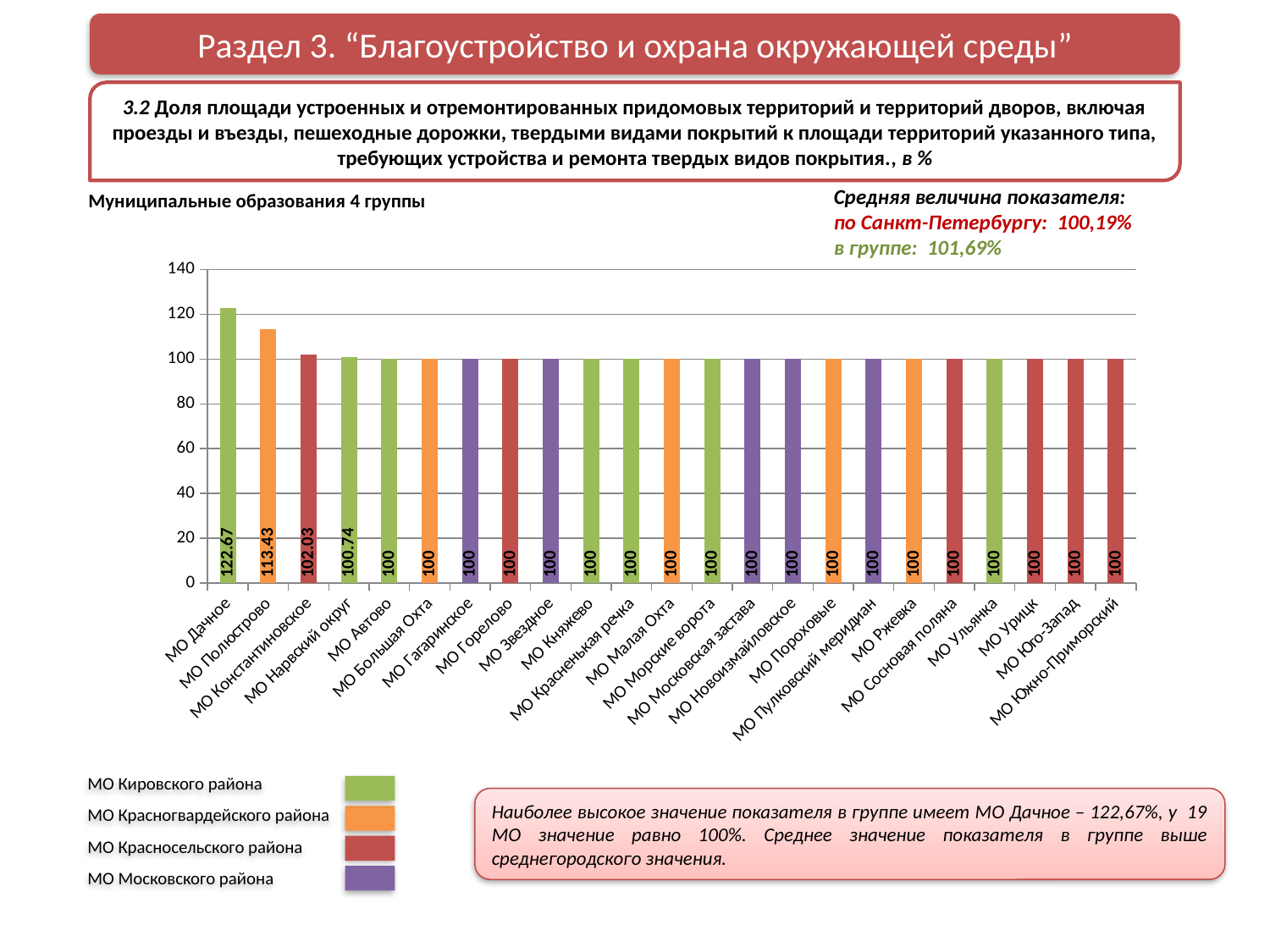
How many municipalities are shown on the chart? 23 What is the value for МО Дачное? 122.67 What is the difference between the values for МО Дачное and МО Полюстрово? 9.24 What is the value for МО Константиновское? 102.03 Which is larger, the value for МО Константиновское or the value for МО Нарвский округ? МО Константиновское How many district groups does the legend list? 4 What kind of chart is shown on the slide? bar chart Which municipality has the highest value on the chart? МО Дачное What is the value for МО Нарвский округ? 100.74 Is the value for МО Полюстрово greater or less than 120? less What is the value for МО Полюстрово? 113.43 What is the value for МО Ульянка? 100